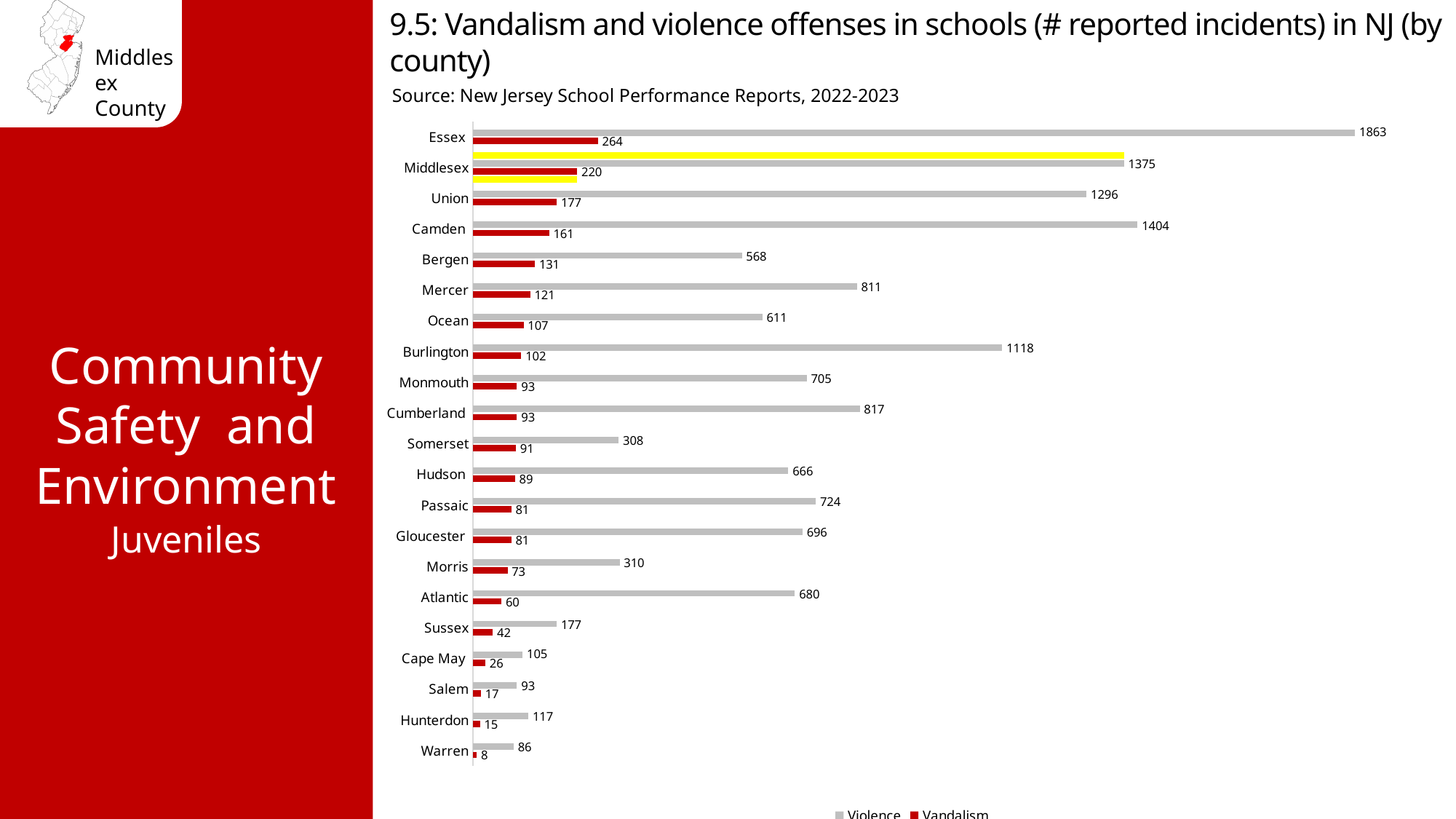
What is the number of reported violence incidents in Middlesex County? 1375 How many series does the legend list? 2 What kind of chart is shown on the slide? Bar chart Which county has the lowest number of reported vandalism incidents? Warren What is the source cited for the chart data? New Jersey School Performance Reports, 2022-2023 What is the difference between the vandalism incidents in Bergen and Mercer? 10 What is the number of reported vandalism incidents in Camden County? 161 Which series is shown in red in the chart? Vandalism What is the difference between the violence incidents in Essex and Middlesex? 488 How many counties are shown in the chart? 21 Which county has the highest number of reported violence incidents? Essex Which county has more reported violence incidents, Camden or Union? Camden